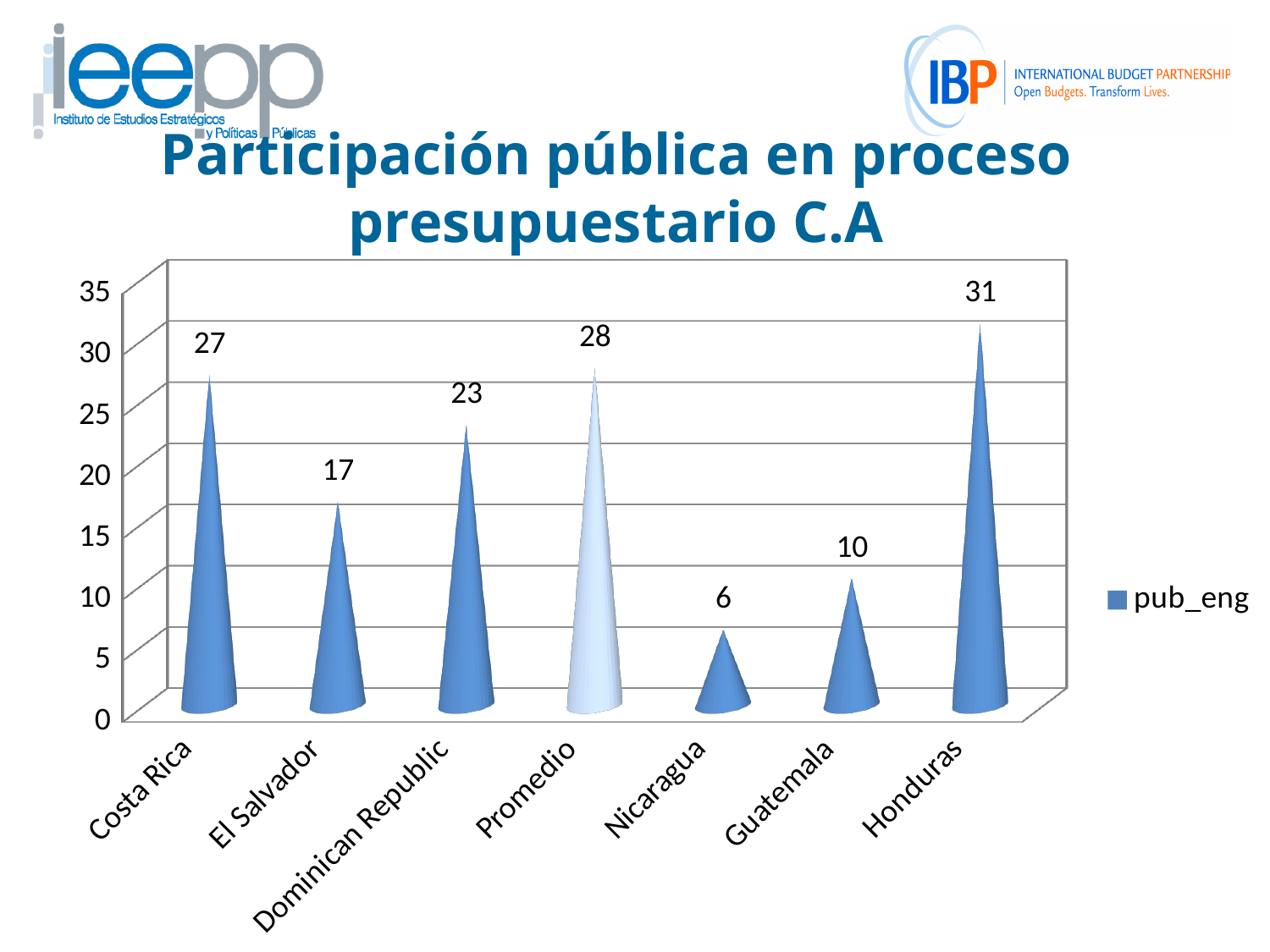
What is the value for Promedio? 28 What is the value for Costa Rica? 27 Is the value for Guatemala greater or less than 15? less How many categories are shown on the x axis? 7 What is the difference between the values for Honduras and Guatemala? 21 What is the name of the series shown in the legend? pub_eng Which category has the highest value? Honduras What is the value for Nicaragua? 6 What kind of chart is shown on the slide? bar chart Which is larger, the value for El Salvador or the value for Dominican Republic? Dominican Republic How many series does the legend list? 1 Which category has the lowest value? Nicaragua